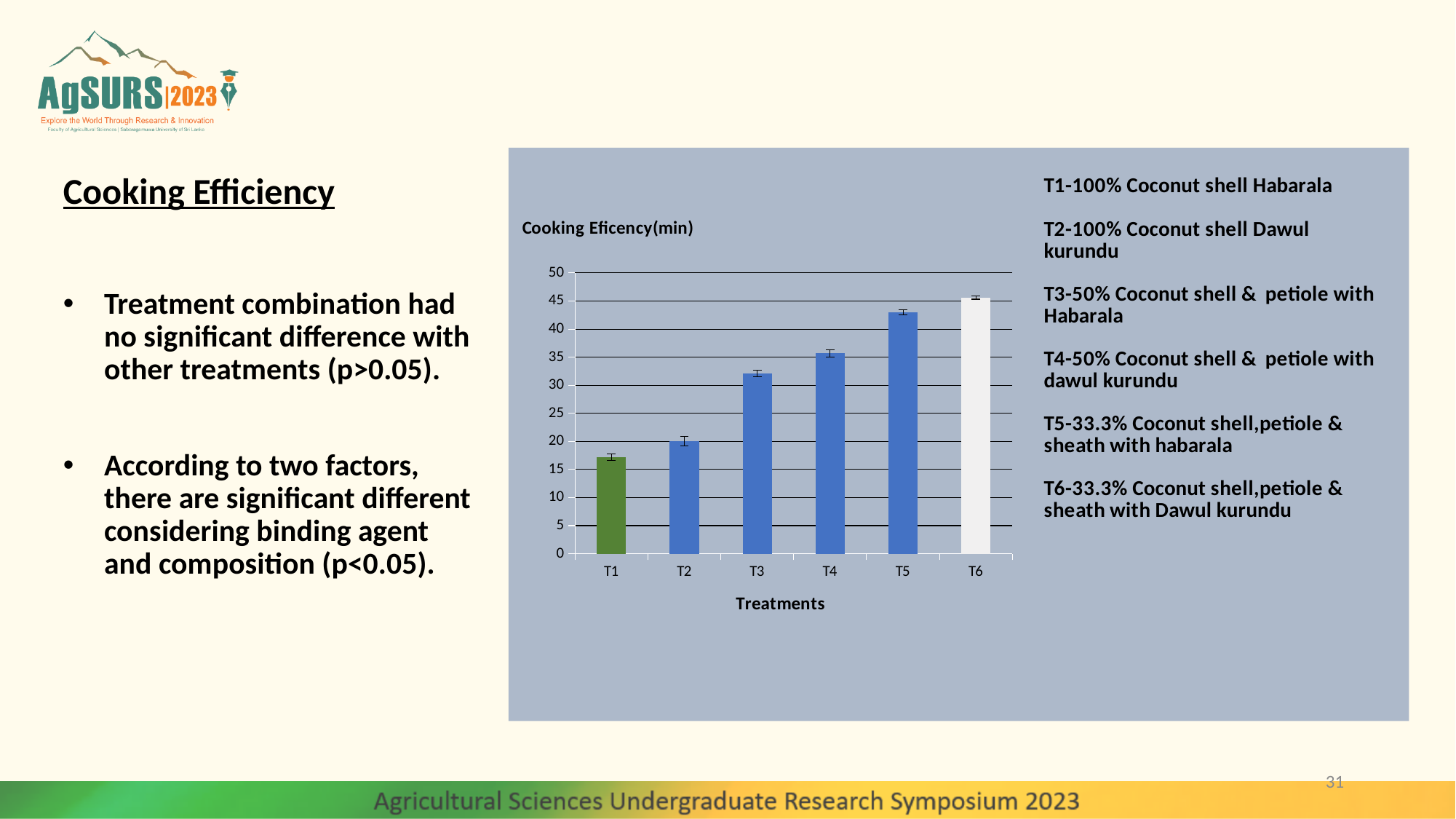
Is the value for T4 greater or less than 40? less Which has a larger value, T2 or T4? T4 Is the value for T3 greater or less than 30? greater Which treatment has the highest cooking efficiency value in the chart? T6 Is the value for T1 greater or less than 20? less What is the label of the x axis of the chart? Treatments Do the values rise or fall from T1 to T6 along the x axis? rise What is the title of the chart? Cooking Eficency(min) How many treatments are plotted on the x axis of the chart? 6 Which treatment has the lowest cooking efficiency value in the chart? T1 What kind of chart is shown on the slide? bar chart